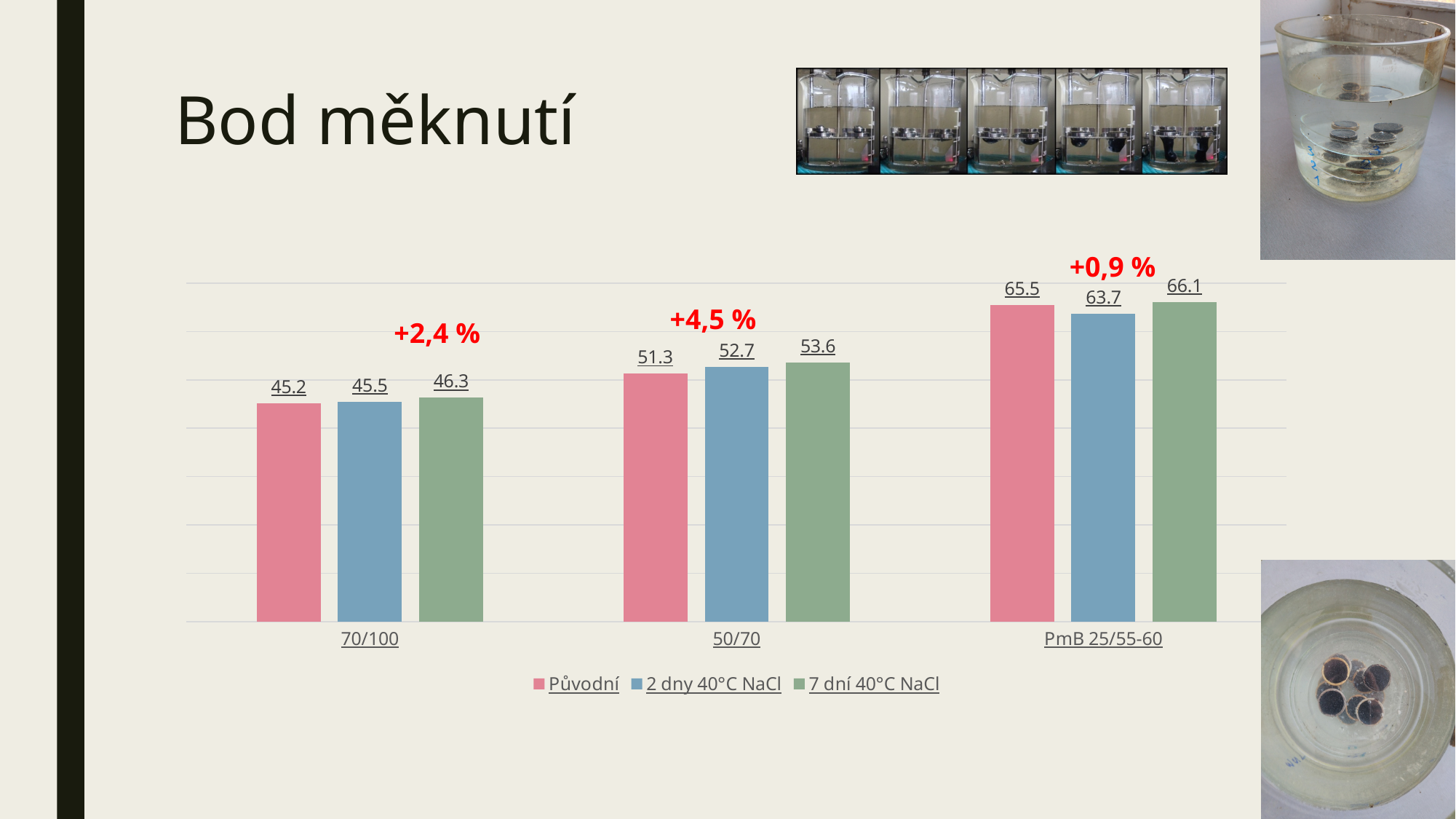
What is the value for Původní in the 70/100 category? 45.2 How many series does the legend list? 3 How many categories are shown on the x axis? 3 What is the difference between the 7 dní 40°C NaCl value and the Původní value in the 50/70 category? 2.3 What is the title of the slide containing the chart? Bod měknutí What percentage change is annotated in red above the 50/70 category? +4,5 % Which category has the highest value for the Původní series? PmB 25/55-60 Which category has the lowest value for the 7 dní 40°C NaCl series? 70/100 What kind of chart is shown on the slide? Bar chart In the PmB 25/55-60 category, which is larger: the Původní value or the 2 dny 40°C NaCl value? Původní What is the value for 2 dny 40°C NaCl in the PmB 25/55-60 category? 63.7 What is the value for 7 dní 40°C NaCl in the 50/70 category? 53.6